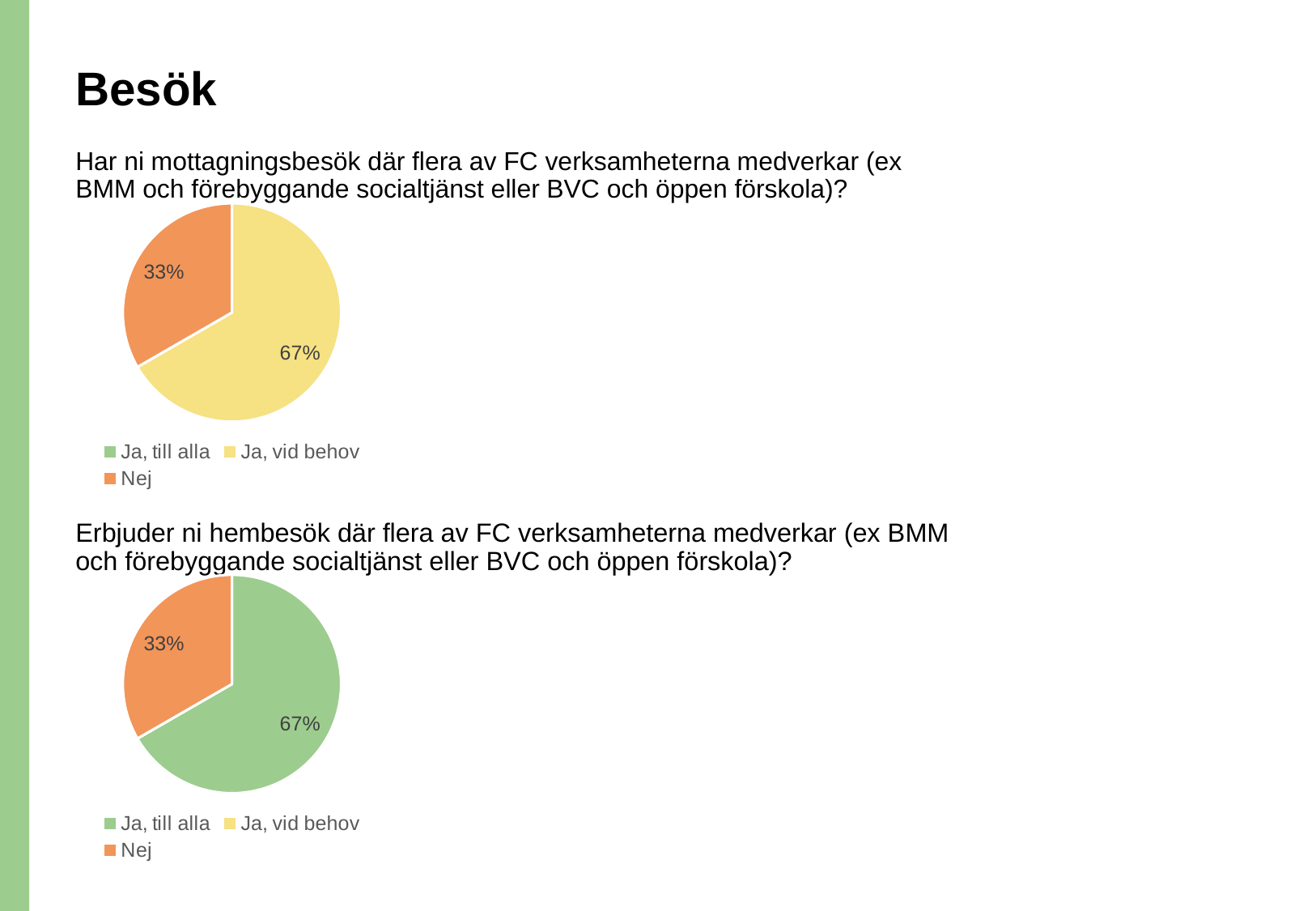
In the bottom chart (hembesök), which is larger: 'Ja, till alla' or 'Nej'? Ja, till alla In the bottom chart (hembesök), which category has the largest slice? Ja, till alla In the bottom chart (hembesök), what share is labelled for the 'Nej' slice? 33% In the top chart (mottagningsbesök), what share is labelled for the 'Ja, vid behov' slice? 67% In the bottom chart (hembesök), what share is labelled for the 'Ja, till alla' slice? 67% In the top chart (mottagningsbesök), what colour is the 'Nej' slice? Orange In the top chart (mottagningsbesök), what is the difference in percentage points between the 'Ja, vid behov' and 'Nej' slices? 34 percentage points In the top chart (mottagningsbesök), what share is labelled for the 'Nej' slice? 33% In the top chart (mottagningsbesök), which category has the largest slice? Ja, vid behov What type of chart is used for both charts on the slide? Pie chart How many entries does the legend of the top chart (mottagningsbesök) list? 3 In the bottom chart (hembesök), which category has the smallest visible slice? Nej